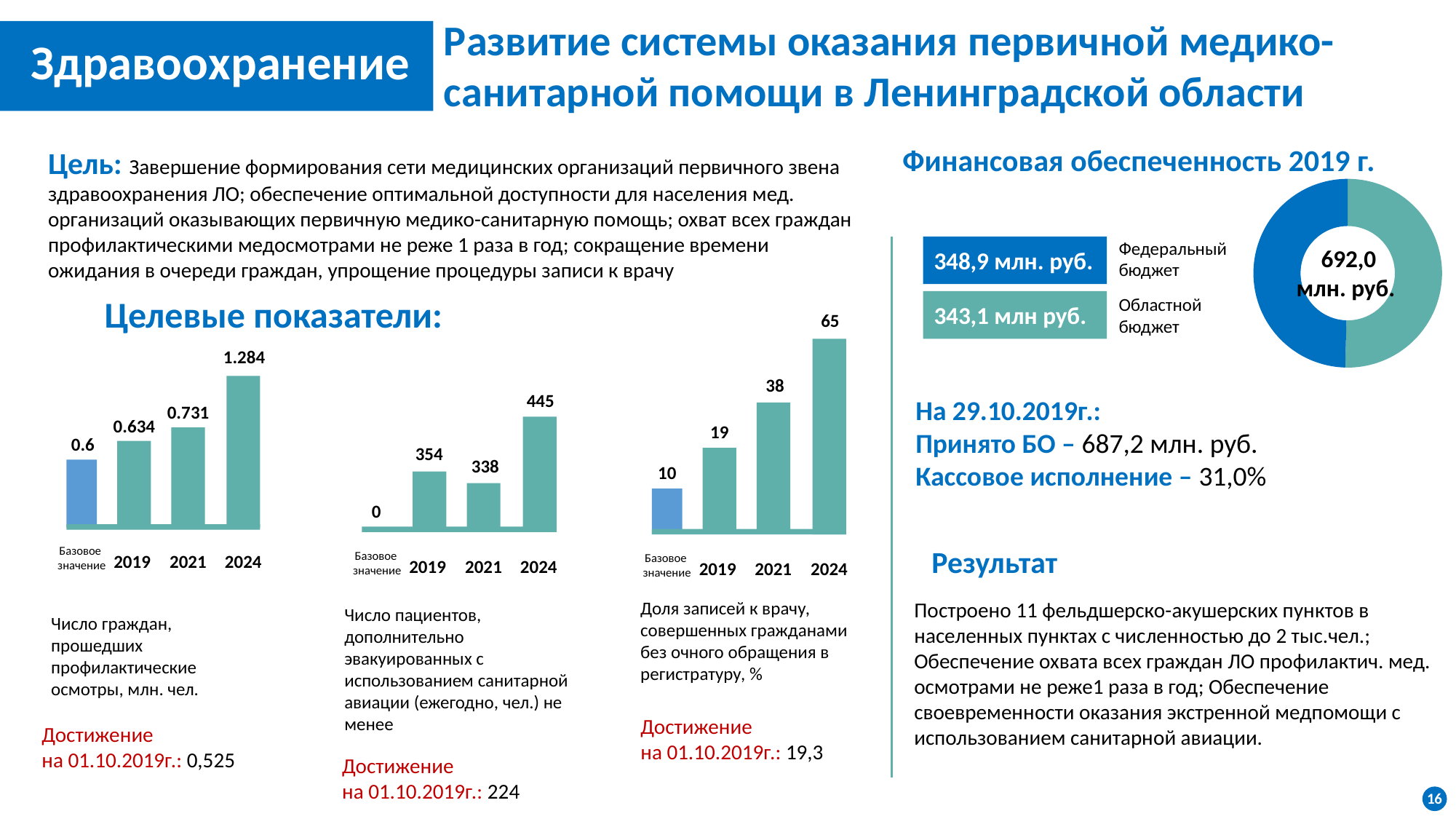
In the right bar chart (share of doctor appointments booked without visiting the registry, %), what is the difference between the 2021 value and the 2019 value? 19 In the donut chart 'Финансовая обеспеченность 2019 г.', what is the value for the federal budget (Федеральный бюджет)? 348,9 млн. руб. What type of chart is used for 'Финансовая обеспеченность 2019 г.'? donut (pie) chart In the middle bar chart (patients evacuated by air ambulance), what is the difference between the 2024 value and the 2021 value? 107 In the left bar chart (number of citizens who underwent preventive check-ups), what is the value for 2021? 0.731 In the right bar chart (share of doctor appointments booked without visiting the registry, %), do the values rise or fall from the base value to 2024? rise How many bars are in the right bar chart (share of doctor appointments booked without visiting the registry, %)? 4 In the right bar chart (share of doctor appointments booked without visiting the registry, %), what is the value for 2024? 65 In the left bar chart (number of citizens who underwent preventive check-ups), what is the value for 2024? 1.284 In the middle bar chart (patients evacuated by air ambulance), which of 2019 or 2021 has the larger value? 2019 In the middle bar chart (patients evacuated by air ambulance), what is the value for 2019? 354 In the left bar chart (number of citizens who underwent preventive check-ups), which category has the lowest value? Базовое значение